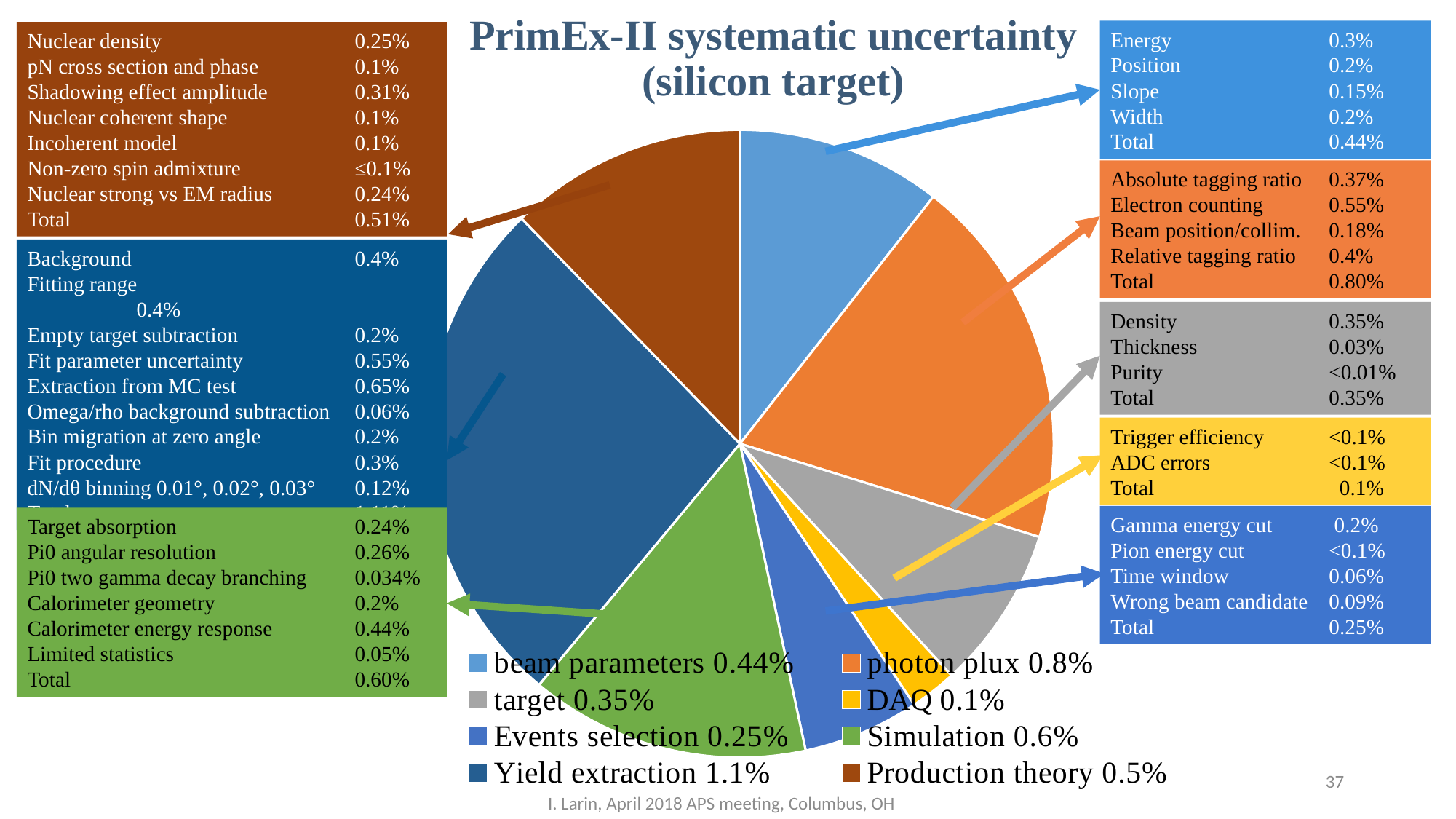
What is the value shown for photon plux in the pie chart legend? 0.8% What is the difference between the Yield extraction value and the Production theory value? 0.6% What is the value shown for Events selection in the pie chart legend? 0.25% What is the value shown for Yield extraction in the pie chart legend? 1.1% What is the value shown for beam parameters in the pie chart legend? 0.44% How many categories does the pie chart have? 8 What is the difference between the photon plux value and the beam parameters value? 0.36% Which category has the largest slice of the pie chart? Yield extraction What type of chart is shown on the slide? Pie chart Which is larger, Simulation or target? Simulation Which category has the smallest slice of the pie chart? DAQ What is the title of the chart? PrimEx-II systematic uncertainty (silicon target)